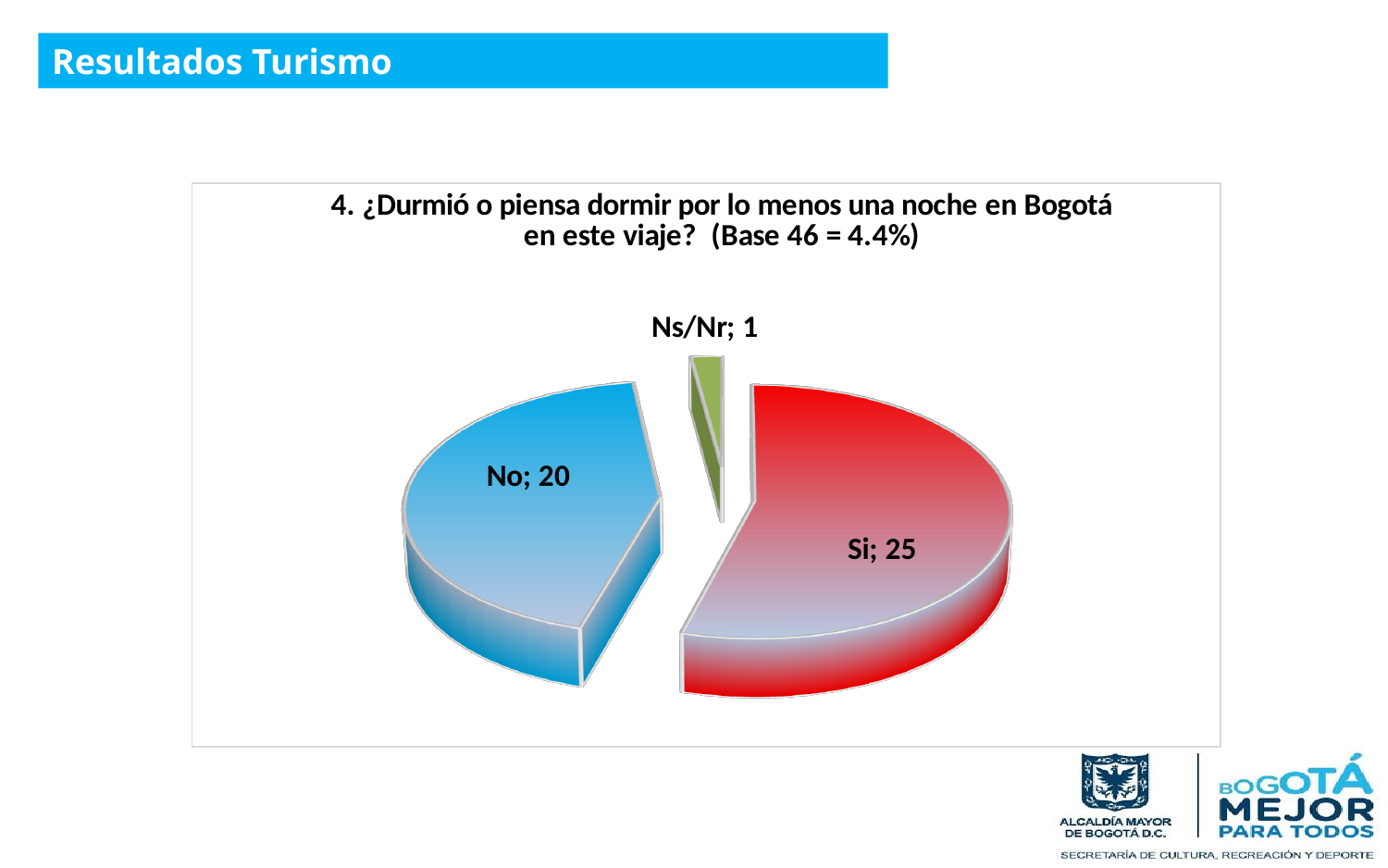
Which is larger in the pie chart, the value for "Si" or the value for "No"? Si Which category has the largest slice in the pie chart? Si What is the value for the "No" slice in the pie chart? 20 What is the value for the "Si" slice in the pie chart? 25 What is the total of all the slice values in the pie chart? 46 Which category has the smallest slice in the pie chart? Ns/Nr What is the difference between the "Si" and "No" values in the pie chart? 5 What colour is the "No" slice in the pie chart? Blue What is the value for the "Ns/Nr" slice in the pie chart? 1 How many slices does the pie chart have? 3 What is the difference between the "No" and "Ns/Nr" values in the pie chart? 19 What kind of chart is shown on the slide? Pie chart